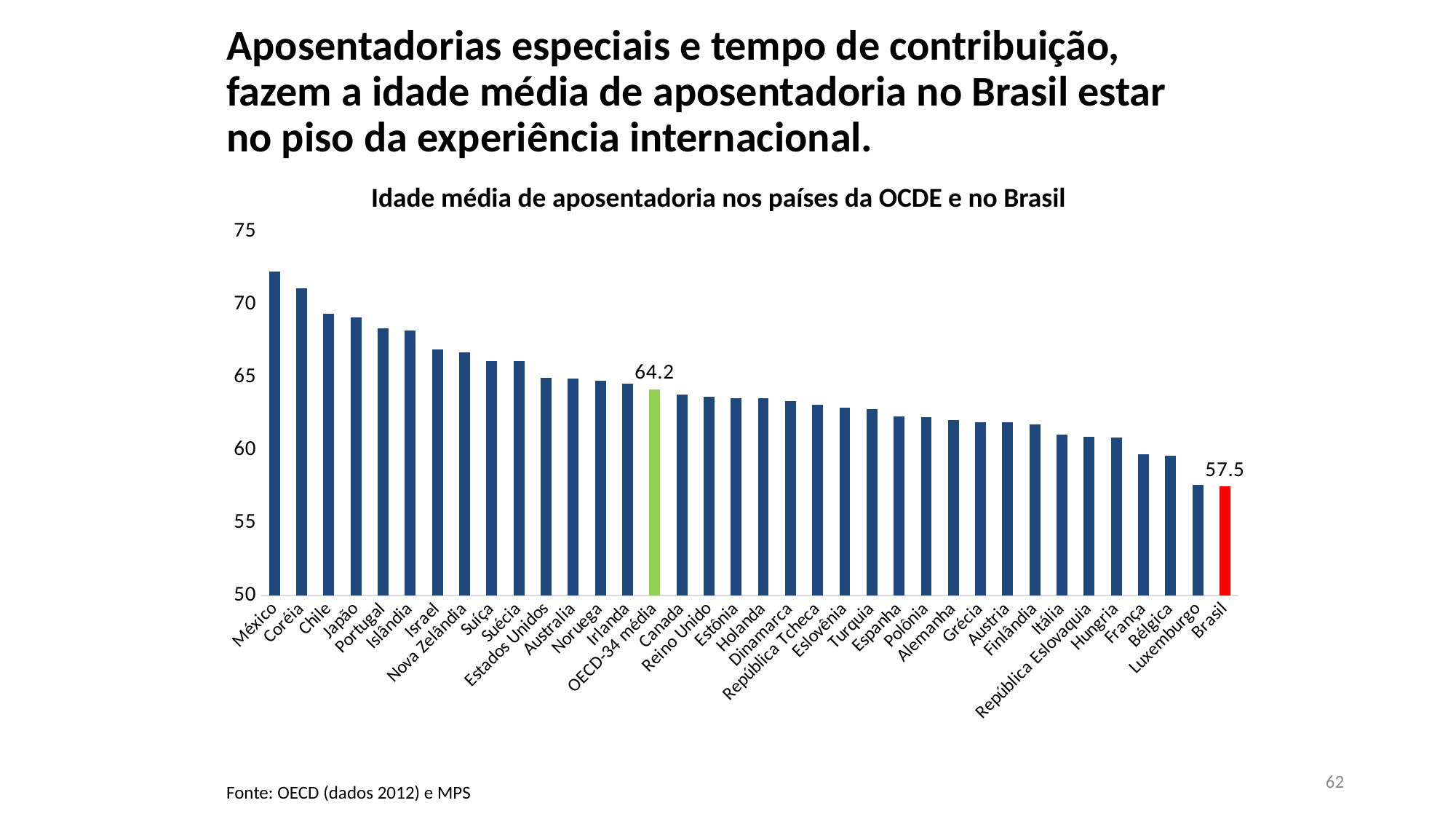
Which category has the highest value? México What is the title of the chart? Idade média de aposentadoria nos países da OCDE e no Brasil Which category has the lowest value? Brasil What colour is the bar for Brasil? red Is the value for México greater or less than 70? greater Which is larger, the value for Chile or the value for Canada? Chile Do the values rise or fall from left to right along the x axis? fall What is the value shown for Brasil? 57.5 Is the value for Luxemburgo greater or less than 60? less What is the value shown for OECD-34 média? 64.2 What is the difference between the OECD-34 média value and the Brasil value? 6.7 What type of chart is shown on the slide? bar chart